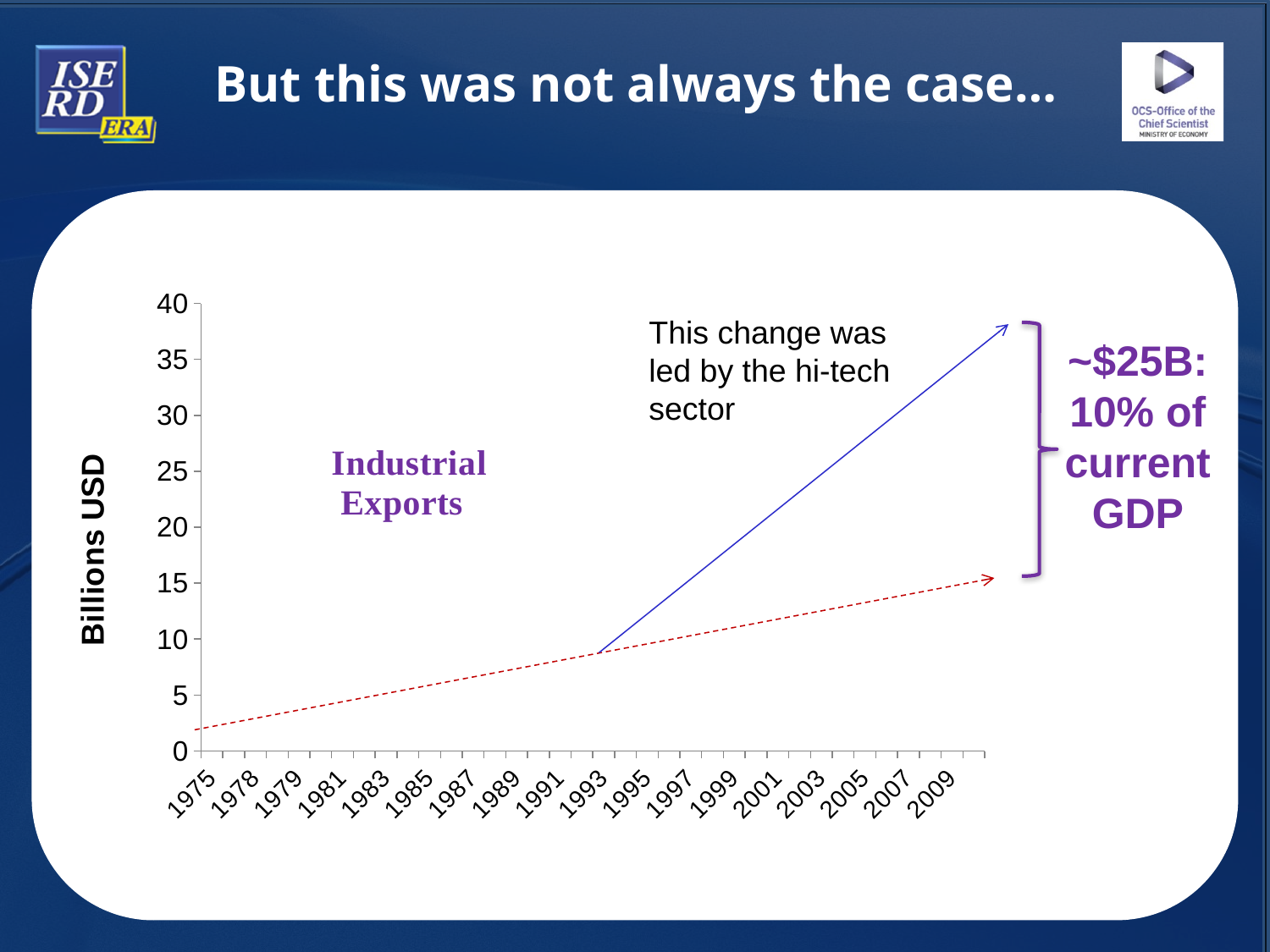
Is the value of the red dashed line at 1975 greater or less than 5? less What is the label of the y axis? Billions USD What kind of chart is shown on the slide? line chart In which year does the solid blue line branch off from the red dashed line? 1993 What is the title shown inside the chart? Industrial Exports Is the value of the red dashed line at 2009 greater or less than 20? less Does the red dashed line rise or fall from 1975 to 2009? rise At 2009, which line is higher: the solid blue line or the red dashed line? the solid blue line How many year labels are shown on the x axis? 18 Is the value of the solid blue line at 2009 greater or less than 35? greater How many lines are plotted on the chart? 2 Does the solid blue line rise or fall from 1993 to 2009? rise